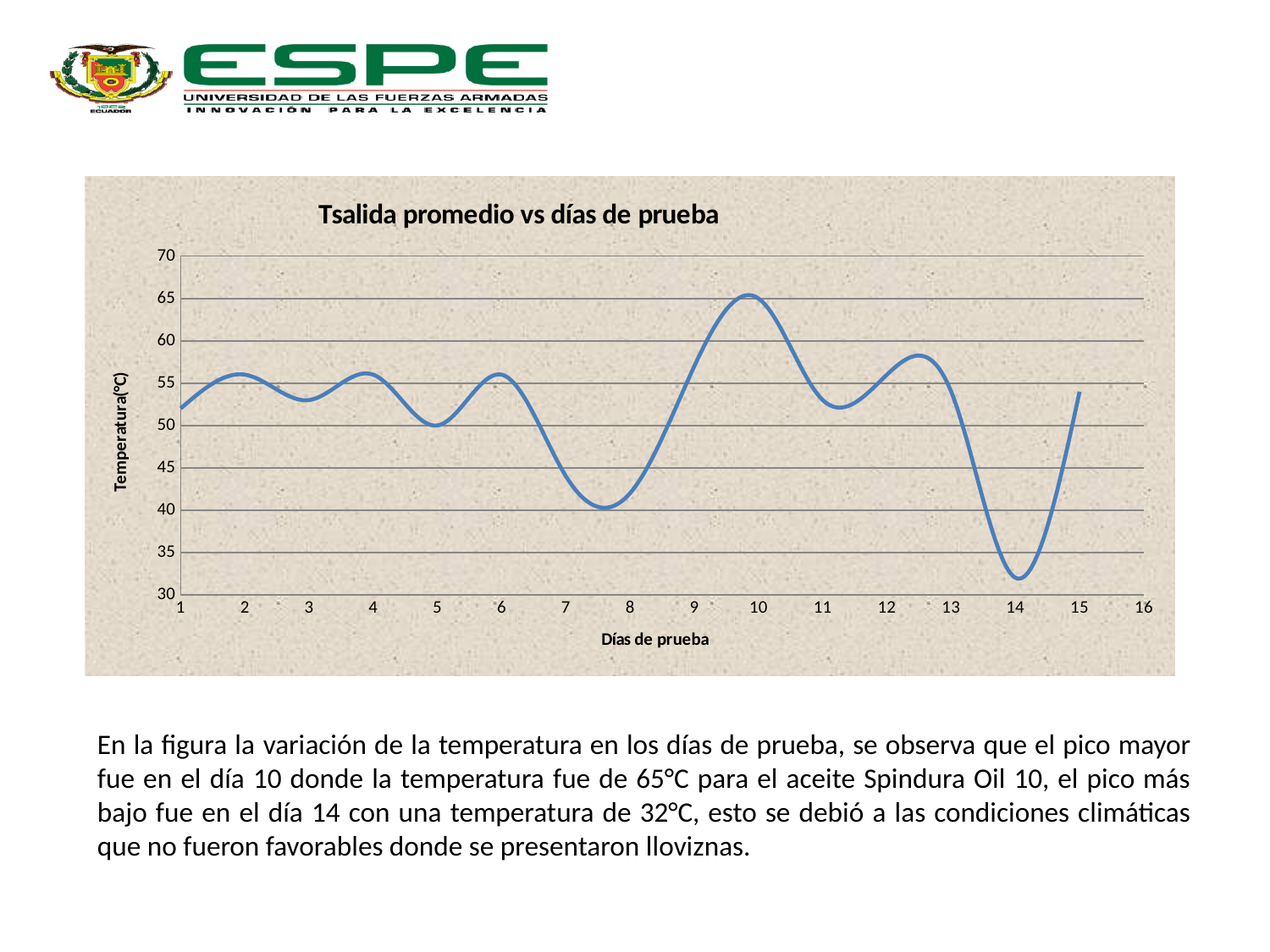
Which day has a higher temperature, day 7 or day 12? day 12 Does the temperature rise or fall between day 13 and day 14? fall Is the temperature on day 7 greater or less than 45? less What type of chart is shown on the slide? line chart Is the temperature on day 10 greater or less than 60? greater According to the slide, what was the temperature on day 10? 65°C What is the label of the vertical axis of the chart? Temperatura(°C) On which test day does the temperature reach its lowest point? 14 On which test day does the temperature reach its highest peak? 10 What is the title of the chart? Tsalida promedio vs días de prueba According to the slide, what was the temperature on day 14? 32°C Is the temperature on day 14 greater or less than 35? less